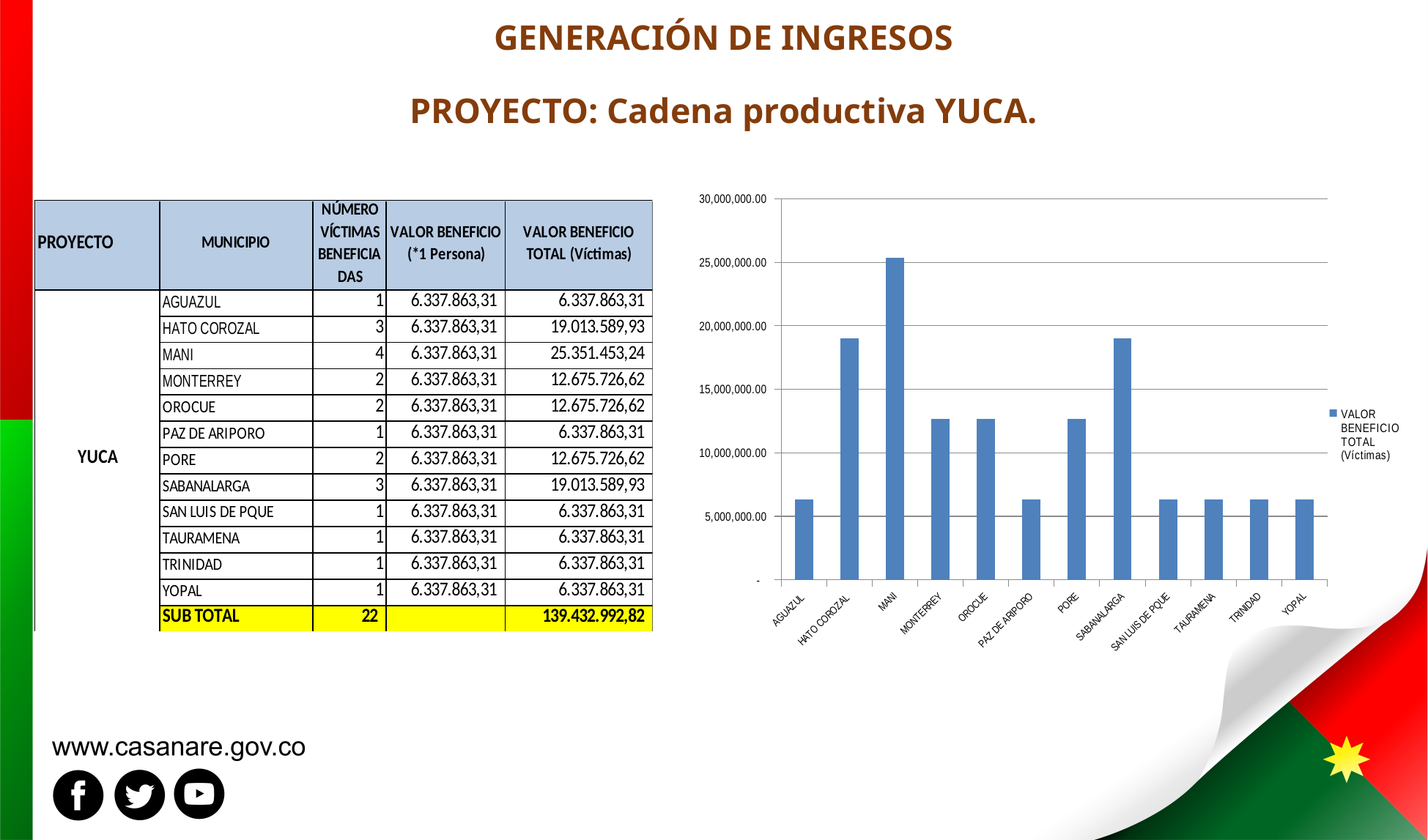
Is the value for MONTERREY greater or less than 15,000,000.00? less What kind of chart is shown on the slide? bar chart Which has a larger VALOR BENEFICIO TOTAL, SABANALARGA or PORE? SABANALARGA Which municipality has the highest VALOR BENEFICIO TOTAL in the chart? MANI Is the value for HATO COROZAL greater or less than 15,000,000.00? greater What is the VALOR BENEFICIO TOTAL (Víctimas) for MANI? 25.351.453,24 What series name does the chart legend show? VALOR BENEFICIO TOTAL (Víctimas) What is the difference between the VALOR BENEFICIO TOTAL for MANI and for HATO COROZAL? 6.337.863,31 Is the value for MANI greater or less than 20,000,000.00? greater How many series does the chart legend list? 1 How many municipalities are shown on the x axis of the chart? 12